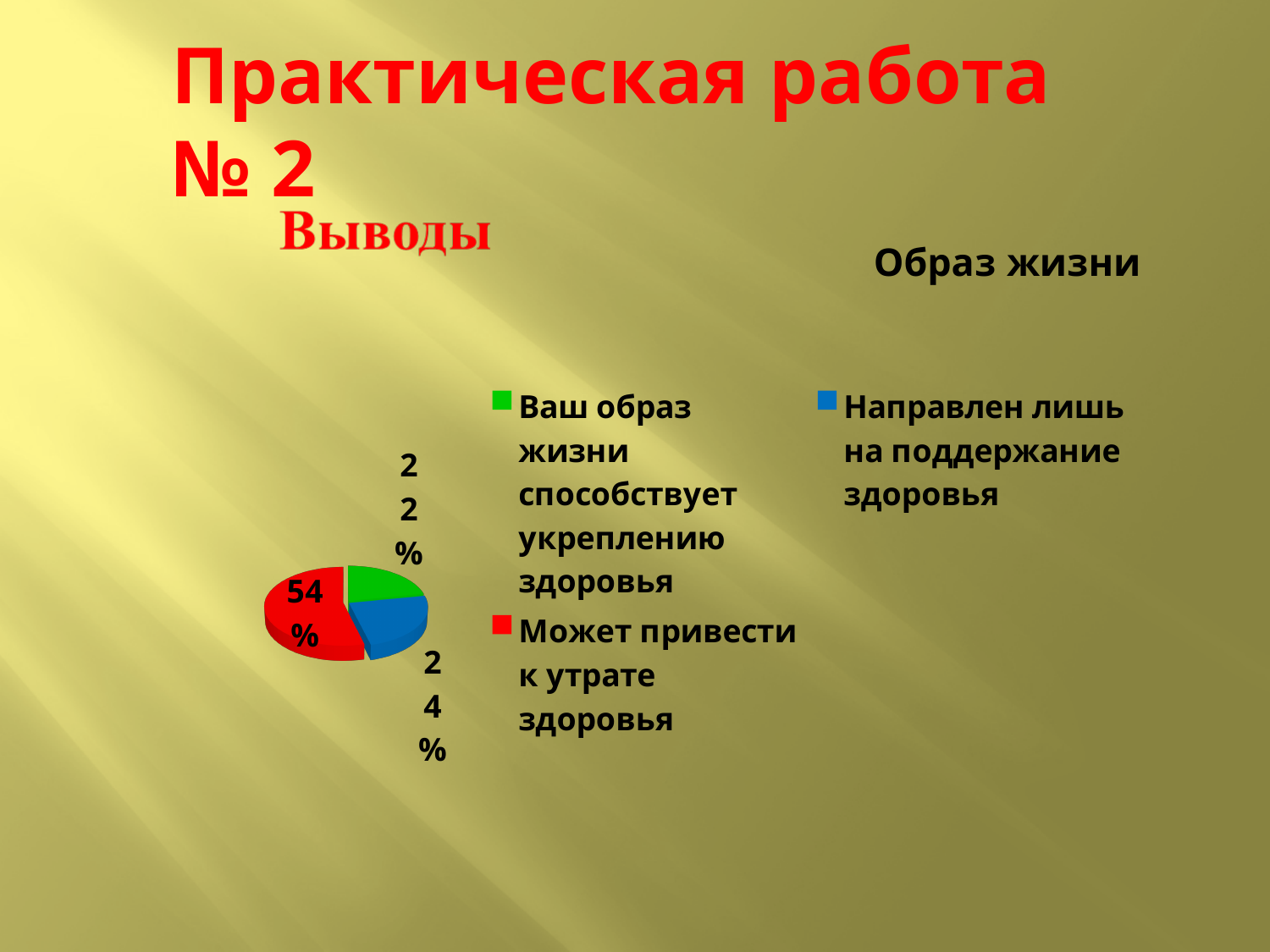
What is the difference between the share for "Может привести к утрате здоровья" and the share for "Направлен лишь на поддержание здоровья"? 30% What is the title of the chart? Образ жизни What share of the pie is labelled "Ваш образ жизни способствует укреплению здоровья"? 22% Which is larger: the share for "Направлен лишь на поддержание здоровья" or the share for "Ваш образ жизни способствует укреплению здоровья"? Направлен лишь на поддержание здоровья How many slices does the pie chart have? 3 How many entries does the chart legend list? 3 Which category has the largest slice of the pie? Может привести к утрате здоровья What kind of chart is shown on the slide? pie chart What share of the pie is labelled "Направлен лишь на поддержание здоровья"? 24% What share of the pie is labelled "Может привести к утрате здоровья"? 54% Which category has the smallest slice of the pie? Ваш образ жизни способствует укреплению здоровья What colour is the slice for "Может привести к утрате здоровья"? red